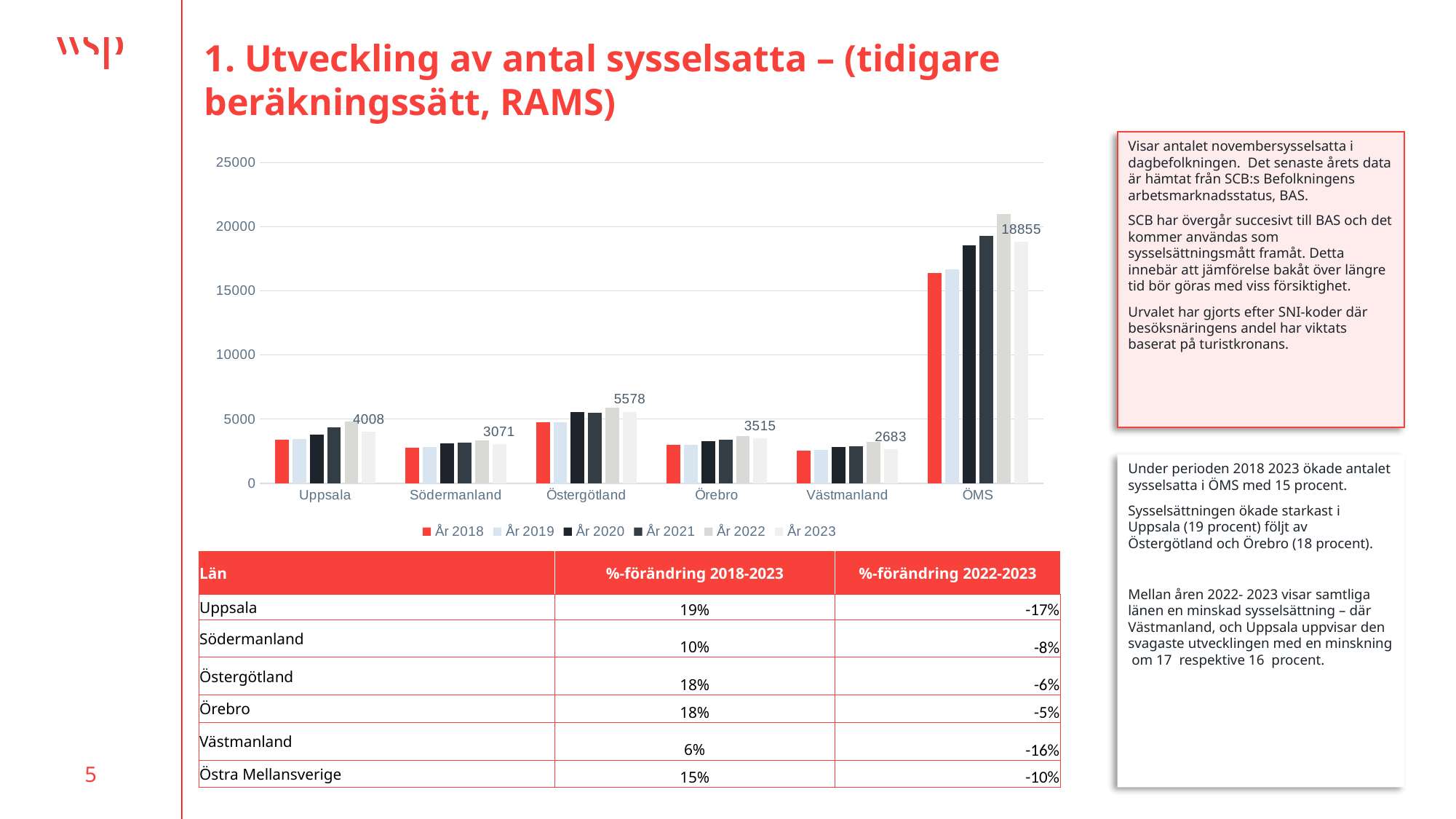
Which category has the lowest labelled År 2023 value? Västmanland Which series is shown in red in the chart legend? År 2018 What is the labelled value for År 2023 for ÖMS? 18855 What is the labelled value for År 2023 for Östergötland? 5578 What is the labelled value for År 2023 for Uppsala? 4008 Which category has the highest values in the chart? ÖMS What is the difference between the labelled År 2023 values for Örebro and Södermanland? 444 Is the År 2022 value for ÖMS greater or less than 20000? greater What is the labelled value for År 2023 for Västmanland? 2683 What kind of chart is shown on the slide? bar chart How many categories (län) are shown on the x axis of the chart? 6 How many series does the chart legend list? 6